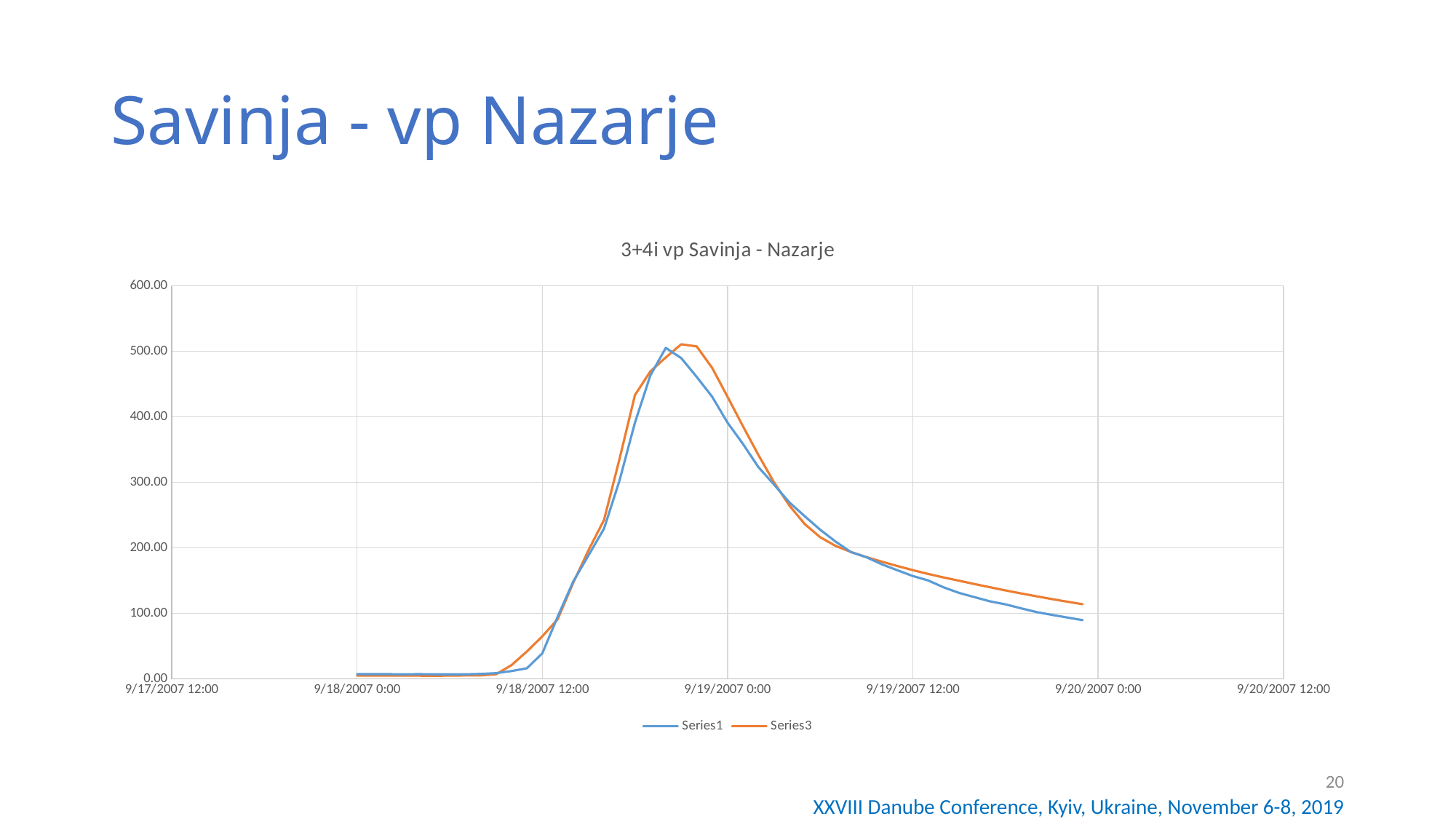
What is the title of the chart? 3+4i vp Savinja - Nazarje Does Series3 rise or fall between 9/19/2007 0:00 and 9/20/2007 0:00? fall At 9/20/2007 0:00, which series has the higher value, Series1 or Series3? Series3 How many series does the legend list? 2 Is the value of Series1 at 9/18/2007 12:00 greater or less than 100? less Is the value of Series1 at 9/18/2007 0:00 greater or less than 100? less Does Series1 rise or fall between 9/18/2007 12:00 and 9/19/2007 0:00? rise What kind of chart is shown on the slide? line chart Is the value of Series1 at 9/19/2007 12:00 greater or less than 200? less Which series is drawn in orange? Series3